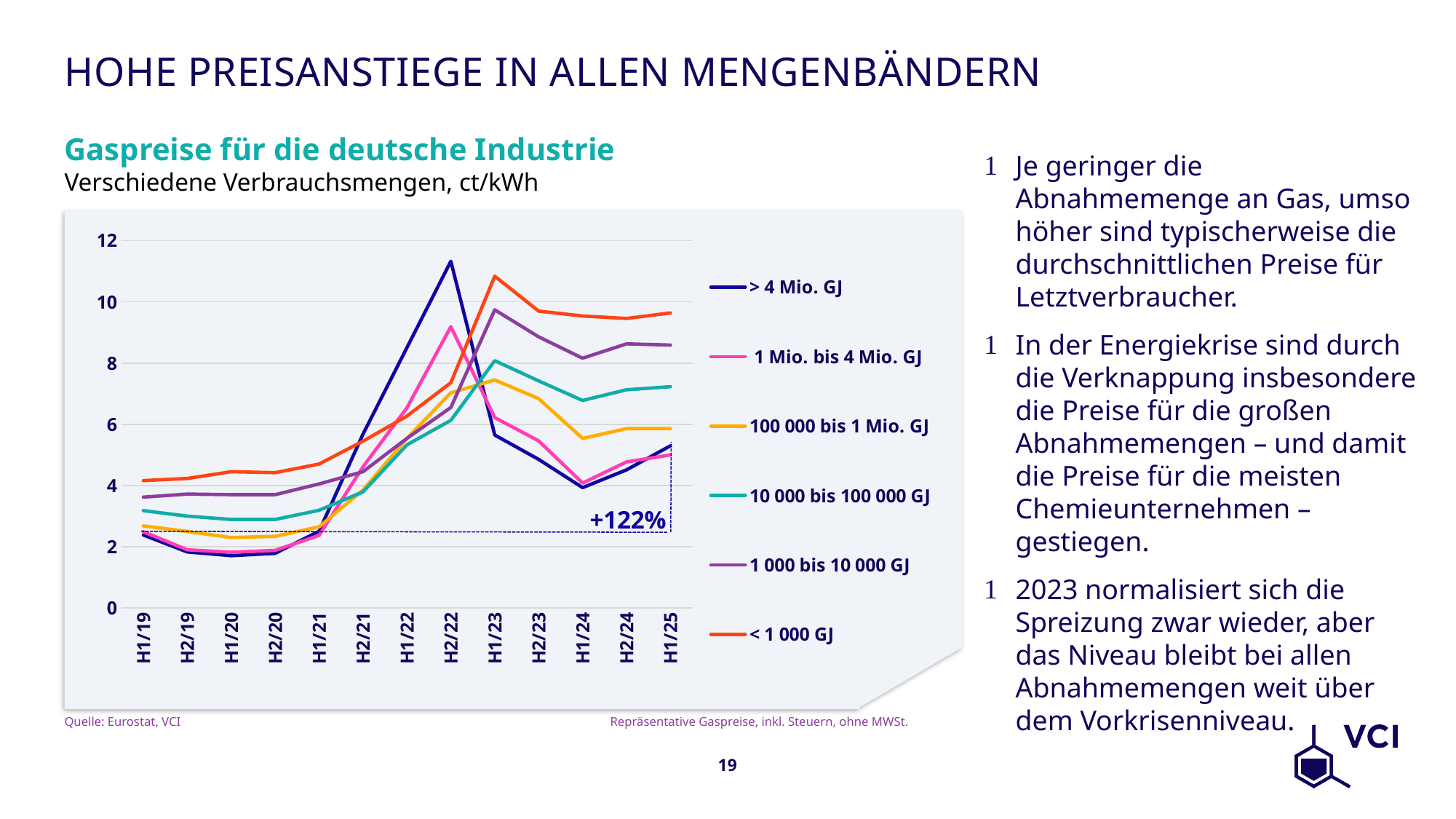
Is the value for > 4 Mio. GJ at H2/22 greater or less than 10? greater At H2/22, which is larger: the value for > 4 Mio. GJ or the value for < 1 000 GJ? > 4 Mio. GJ Does the > 4 Mio. GJ series rise or fall from H2/22 to H1/24? fall Is the value for < 1 000 GJ at H1/25 greater or less than 8? greater Which series has the highest value at H1/25? < 1 000 GJ What kind of chart is shown on the slide? line chart How many half-year periods are shown on the x axis of the chart? 13 How many series does the chart legend list? 6 What percentage change is annotated on the chart? +122% Which series reaches the highest value at H2/22? > 4 Mio. GJ Is the value for 10 000 bis 100 000 GJ at H1/19 greater or less than 4? less